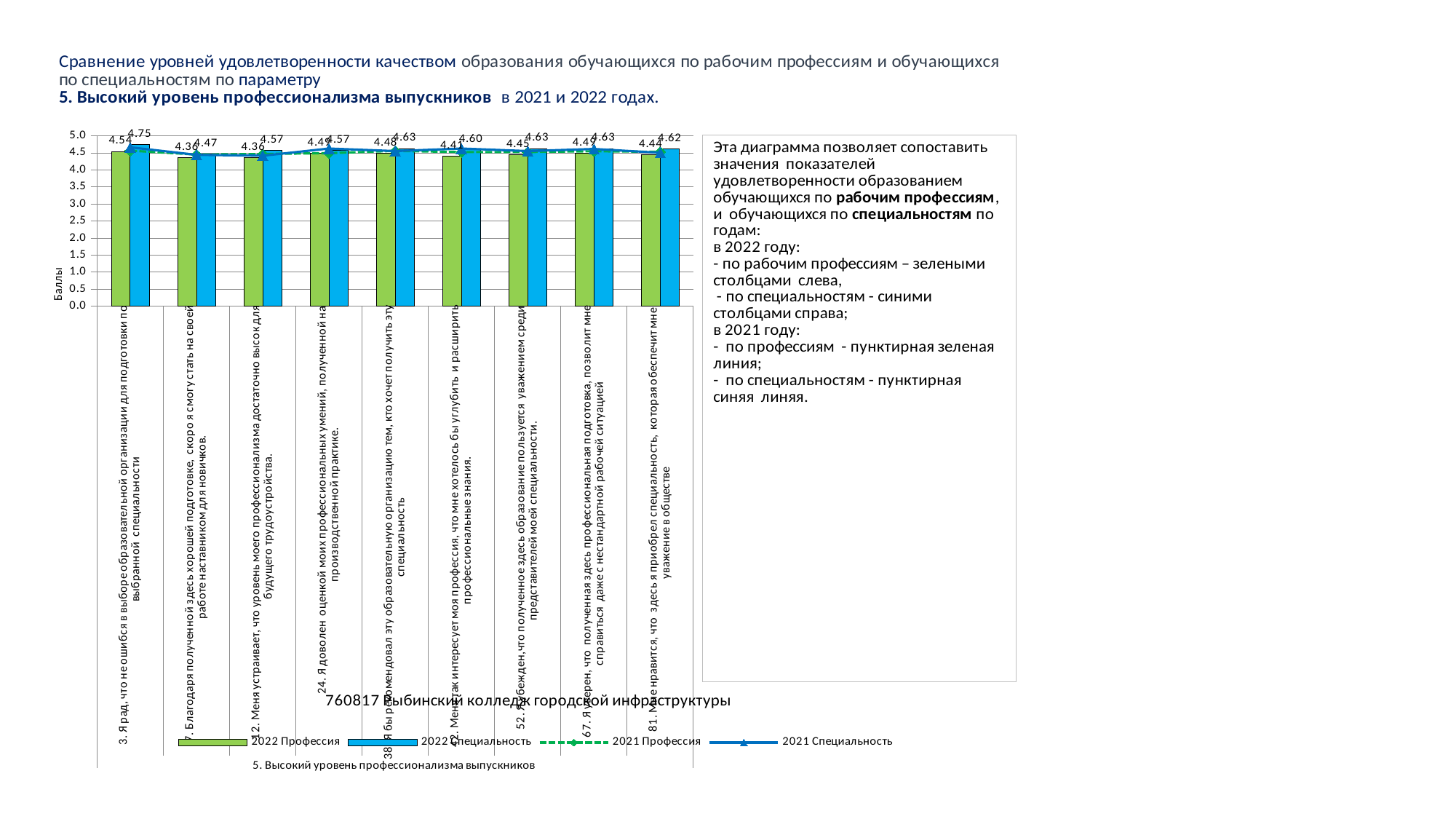
Which statement has the highest 2022 Специальность value? 3. Я рад, что не ошибся в выборе образовательной организации для подготовки по выбранной специальности How many categories (statements) are plotted along the x axis of the chart? 9 What is the 2022 Специальность value for statement 81 (Мне нравится, что здесь я приобрел специальность...)? 4.62 What is the title of the vertical axis of the chart? Баллы What is the 2022 Специальность value for statement 3 (Я рад, что не ошибся в выборе образовательной организации...)? 4.75 For statement 52, which is larger: the 2022 Профессия value or the 2022 Специальность value? 2022 Специальность What is the difference between the 2022 Специальность and 2022 Профессия values for statement 3? 0.21 How many series does the chart legend list? 4 What kind of chart is shown on the slide? combination bar and line chart What is the 2022 Профессия value for statement 3 (Я рад, что не ошибся в выборе образовательной организации...)? 4.54 What is the 2022 Профессия value for statement 52 (Я убежден, что полученное здесь образование пользуется уважением...)? 4.45 Which statement has the lowest 2022 Специальность value? 7. Благодаря полученной здесь хорошей подготовке, скоро я смогу стать на своей работе наставником для новичков